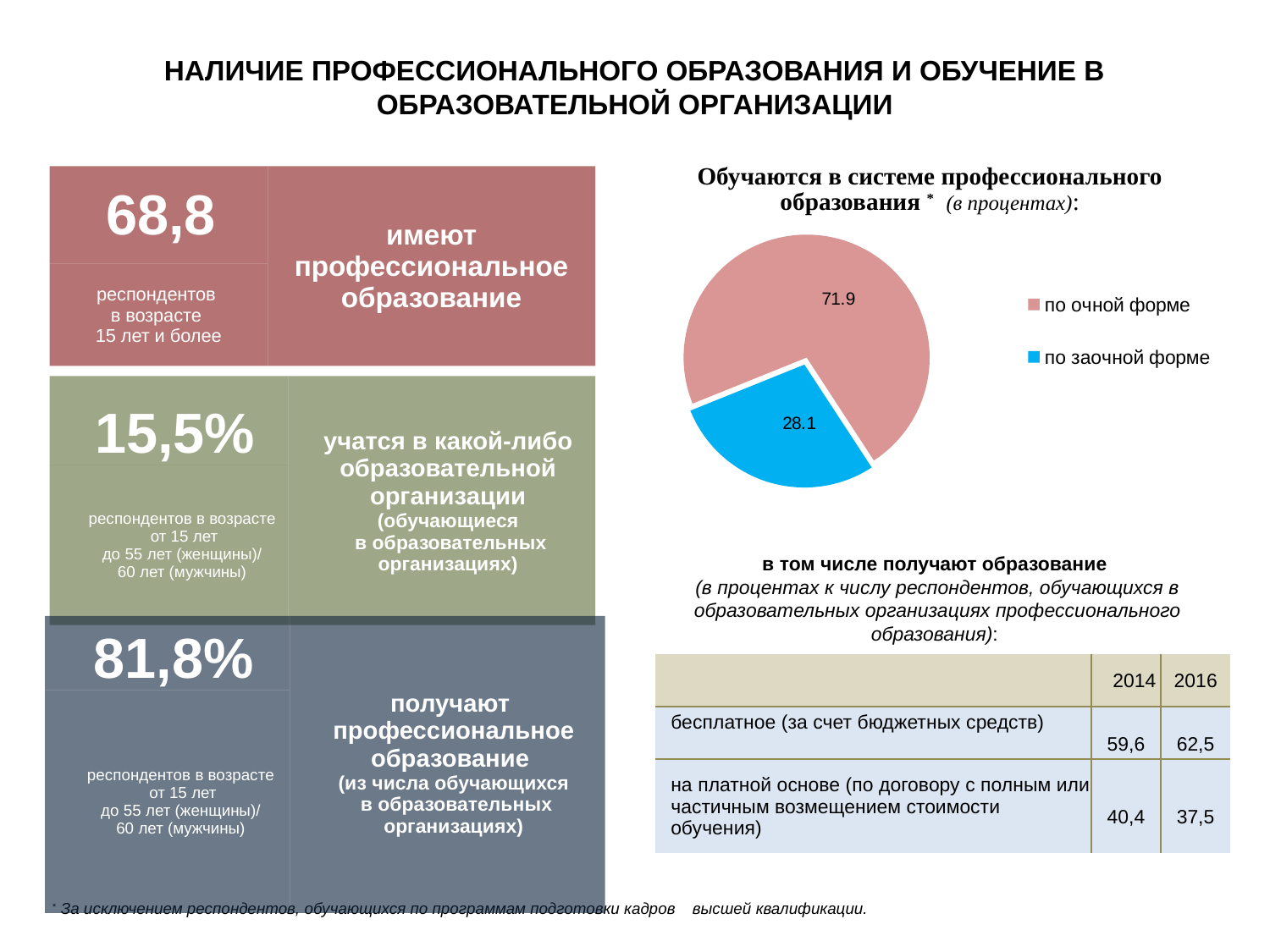
What is the value for "по заочной форме" in the pie chart? 28.1 What kind of chart is shown on the slide? pie chart What is the title of the pie chart? Обучаются в системе профессионального образования (в процентах) Which category has the smallest slice in the pie chart? по заочной форме How many entries does the legend of the pie chart list? 2 How many slices does the pie chart have? 2 What is the value for "по очной форме" in the pie chart? 71.9 Which category has the largest slice in the pie chart? по очной форме What colour is the "по заочной форме" slice in the pie chart? blue What is the difference between the values for "по очной форме" and "по заочной форме" in the pie chart? 43.8 What share of the pie does the "по заочной форме" slice represent? 28.1% Which is larger in the pie chart: "по очной форме" or "по заочной форме"? по очной форме